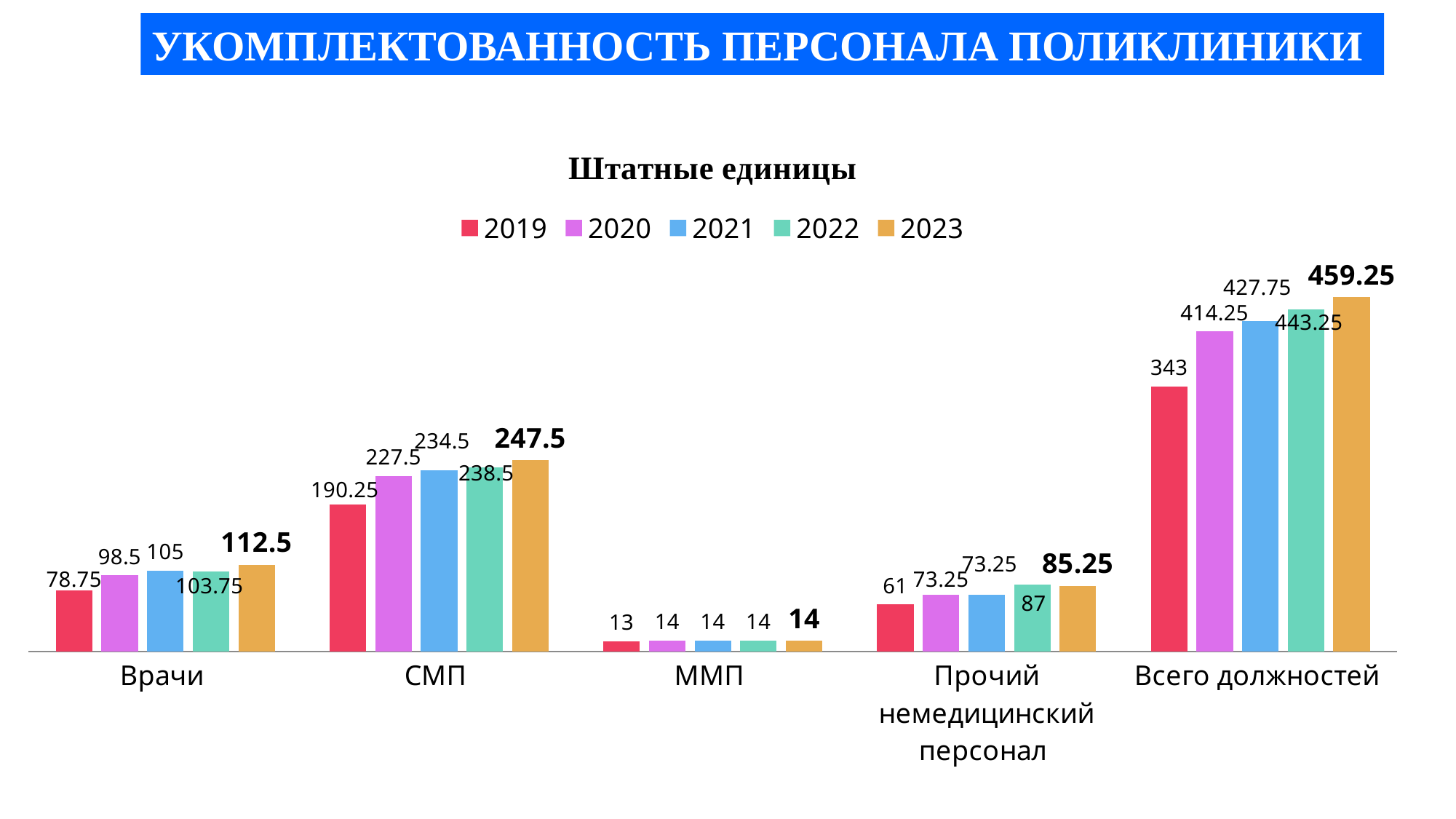
How many series does the legend list? 5 What is the value for Врачи in 2023? 112.5 Which year has the highest value for Всего должностей? 2023 What is the difference between the 2023 and 2019 values for Всего должностей? 116.25 Which year has the lowest value for Врачи? 2019 What kind of chart is shown? bar chart What is the value for Всего должностей in 2021? 427.75 What is the title of the chart? Штатные единицы How many categories are shown on the x axis? 5 Which is larger for СМП: the 2022 value or the 2021 value? 2022 What is the value for СМП in 2019? 190.25 What is the value for Прочий немедицинский персонал in 2022? 87